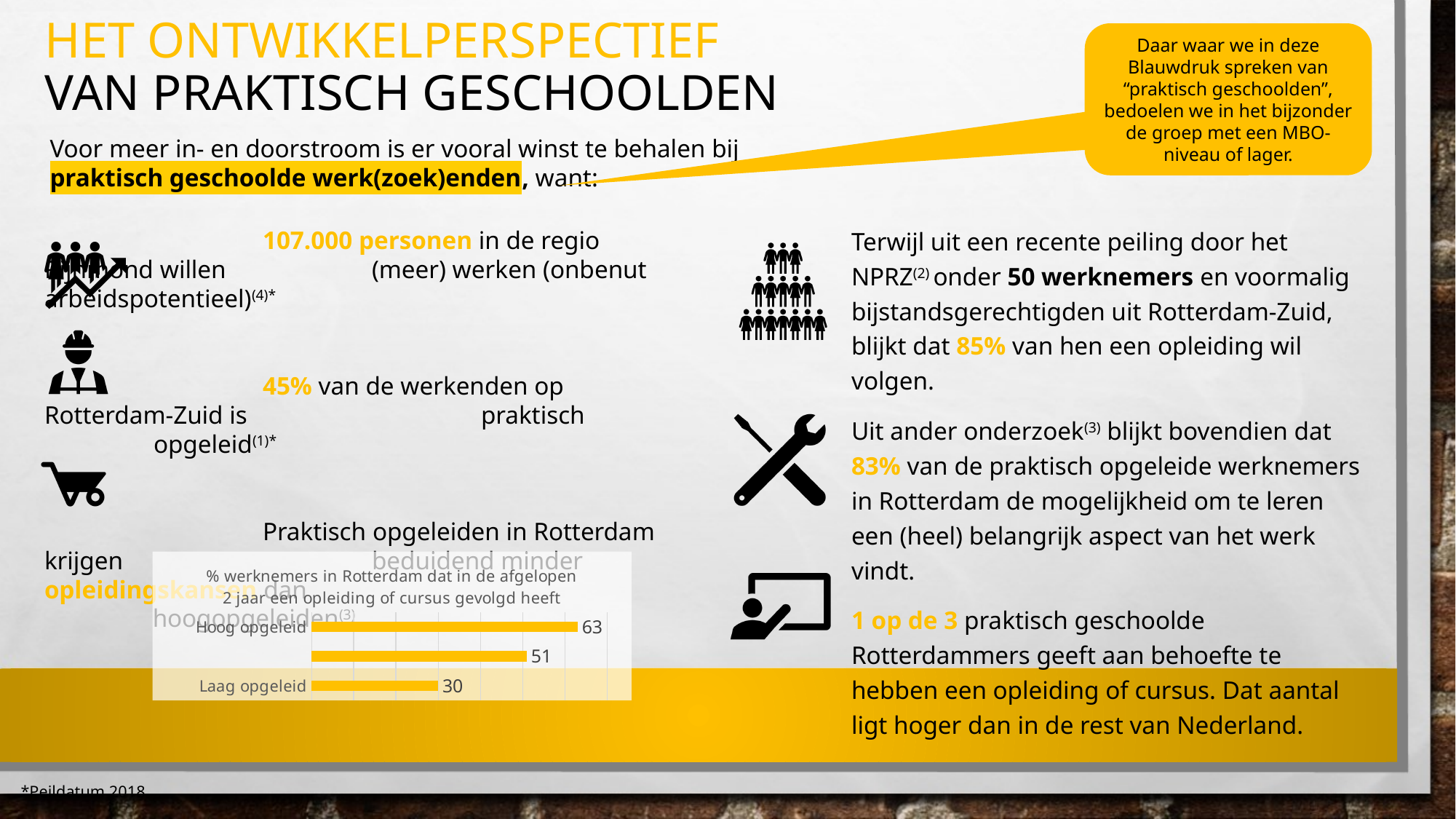
What is the difference between the values for Hoog opgeleid and Laag opgeleid? 33 What type of chart is shown on the slide? bar chart How many bars are plotted in the chart? 3 Which category has the highest value in the chart? Hoog opgeleid What is the value for Laag opgeleid in the chart? 30 Which is larger, the value for Hoog opgeleid or the value for Laag opgeleid? Hoog opgeleid What is the title of the chart? % werknemers in Rotterdam dat in de afgelopen 2 jaar een opleiding of cursus gevolgd heeft Which category has the lowest value in the chart? Laag opgeleid What is the value shown on the middle bar of the chart? 51 What colour are the bars in the chart? yellow What is the value for Hoog opgeleid in the chart? 63